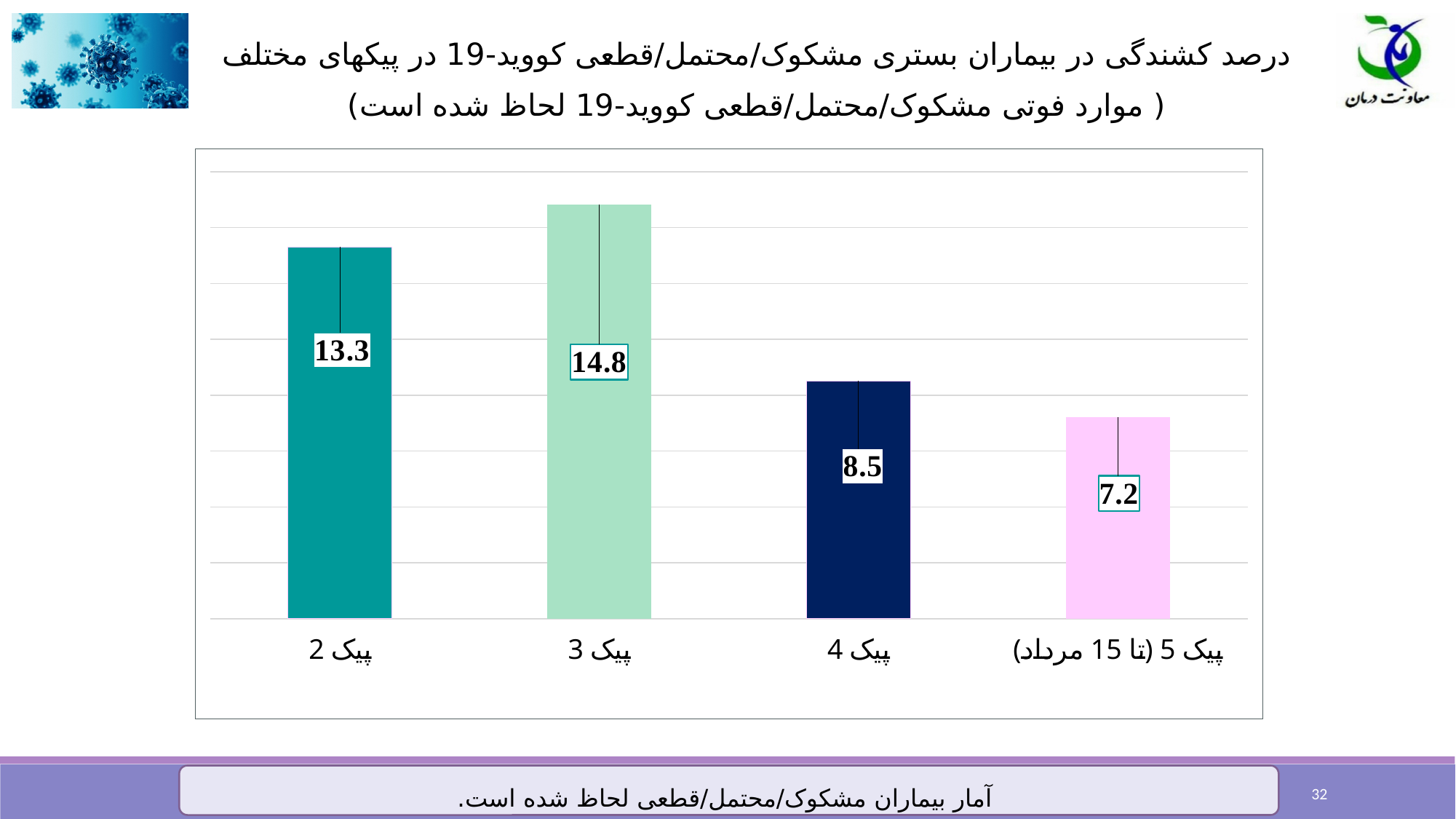
What is the value shown for پیک 4 (Peak 4)? 8.5 How many peaks (categories) are shown on the chart? 4 Which is larger, the value for پیک 2 or the value for پیک 4? پیک 2 Do the values rise or fall from پیک 3 to پیک 5 (تا 15 مرداد) along the x axis? Fall Which peak has the lowest value? پیک 5 (تا 15 مرداد) What is the value shown for پیک 2 (Peak 2)? 13.3 What is the value shown for پیک 3 (Peak 3)? 14.8 What is the difference between the values for پیک 3 and پیک 2? 1.5 Which peak has the highest value? پیک 3 What is the difference between the values for پیک 4 and پیک 5 (تا 15 مرداد)? 1.3 What is the value shown for پیک 5 (تا 15 مرداد) (Peak 5)? 7.2 What kind of chart is shown on the slide? Bar chart